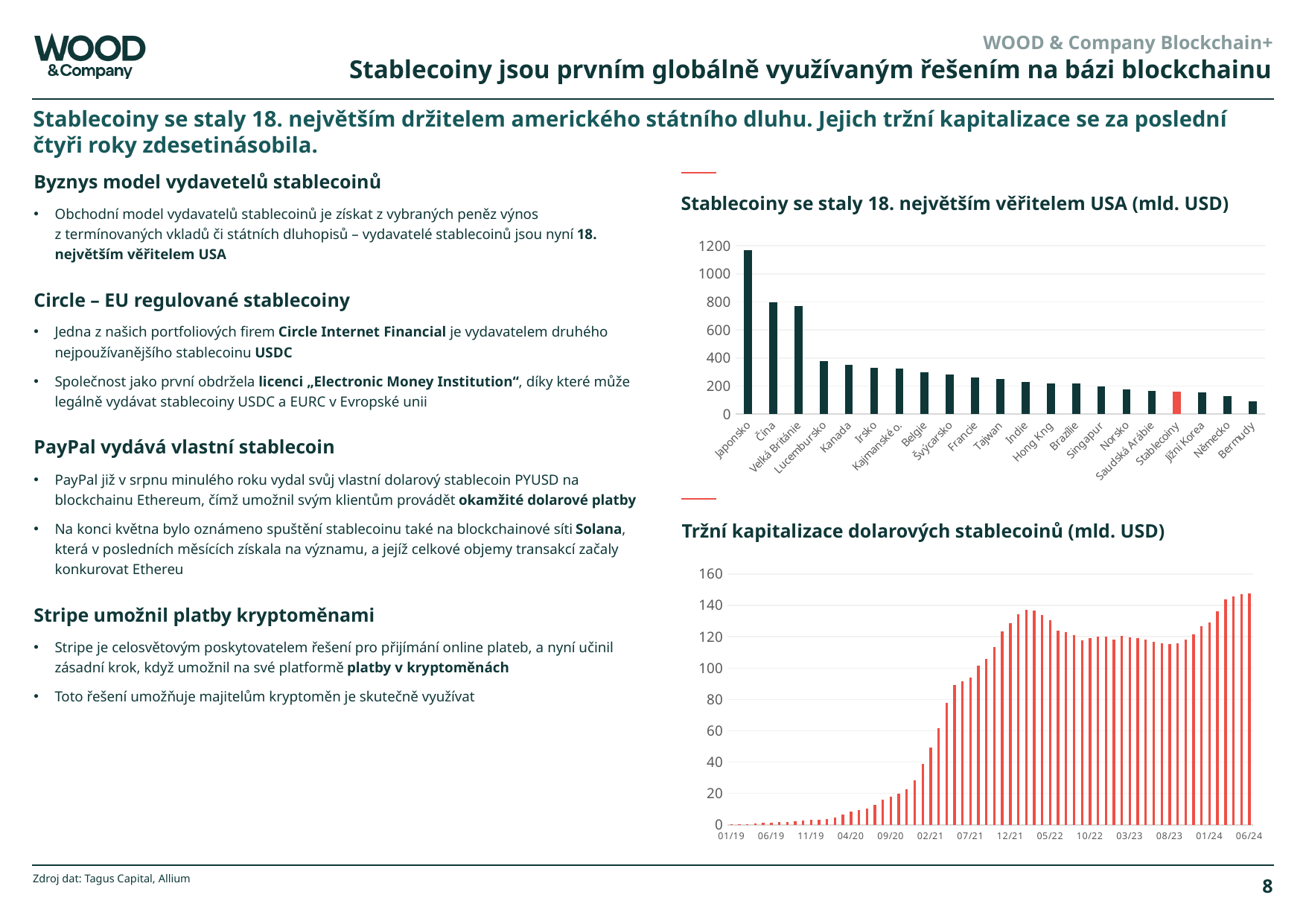
What kind of chart is the chart titled 'Tržní kapitalizace dolarových stablecoinů (mld. USD)'? bar chart In the chart 'Stablecoiny se staly 18. největším věřitelem USA (mld. USD)', which category's bar is coloured red instead of dark green? Stablecoiny In the chart 'Stablecoiny se staly 18. největším věřitelem USA (mld. USD)', is the value for Lucembursko greater or less than 400? less In the chart 'Stablecoiny se staly 18. největším věřitelem USA (mld. USD)', which category has the highest value? Japonsko In the chart 'Stablecoiny se staly 18. největším věřitelem USA (mld. USD)', which category has the lowest value? Bermudy In the chart 'Tržní kapitalizace dolarových stablecoinů (mld. USD)', do the values overall rise or fall from 01/19 to 06/24? rise How many categories are shown on the x axis of the chart 'Stablecoiny se staly 18. největším věřitelem USA (mld. USD)'? 21 In the chart 'Stablecoiny se staly 18. největším věřitelem USA (mld. USD)', is the value for Stablecoiny greater or less than 200? less In the chart 'Stablecoiny se staly 18. největším věřitelem USA (mld. USD)', is the value for Japonsko greater or less than 1000? greater In the chart 'Stablecoiny se staly 18. největším věřitelem USA (mld. USD)', which is larger, the value for Čína or the value for Lucembursko? Čína What kind of chart is the chart titled 'Stablecoiny se staly 18. největším věřitelem USA (mld. USD)'? bar chart